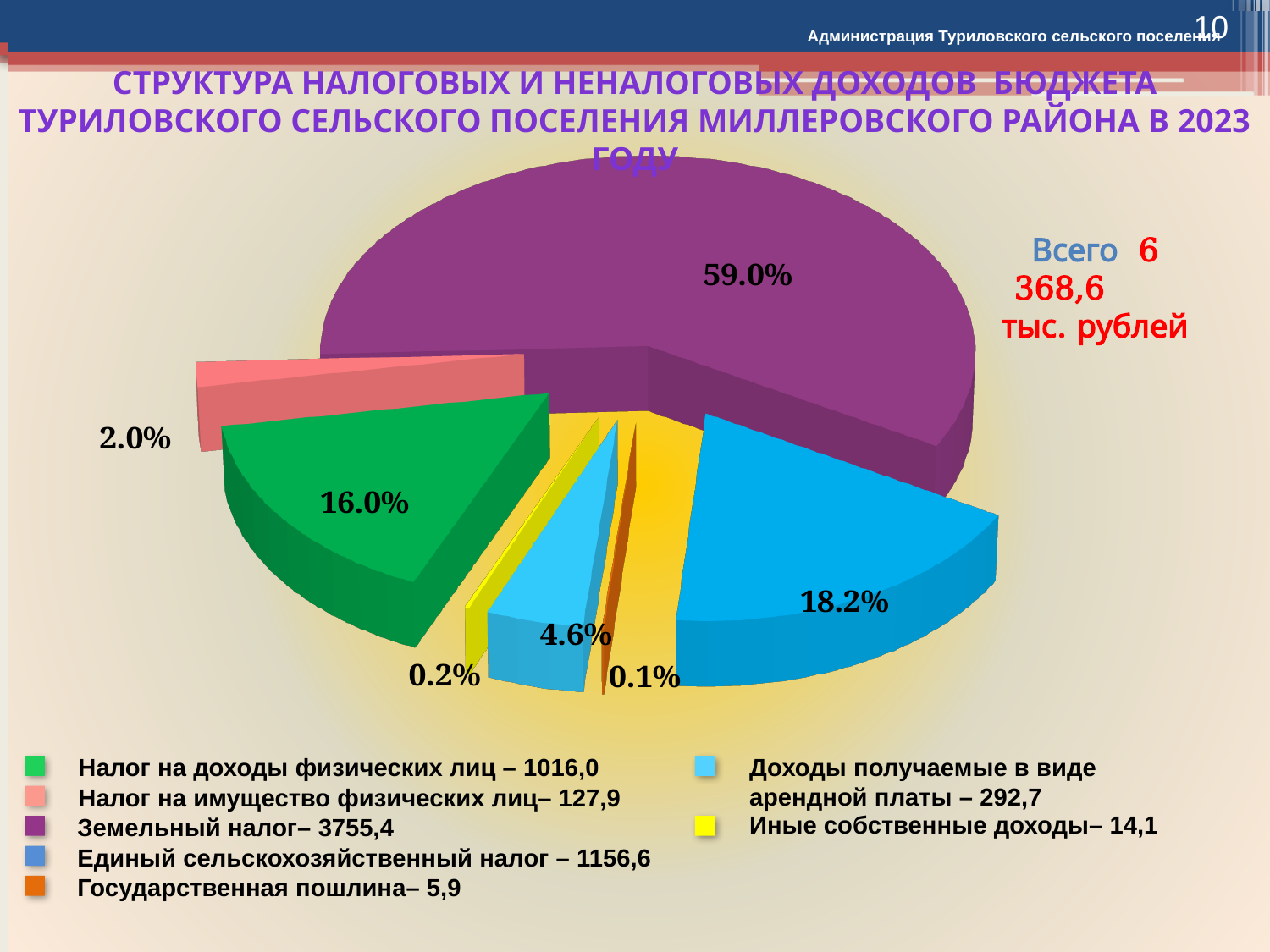
What percentage is shown for the blue slice (Единый сельскохозяйственный налог)? 18.2% How many slices does the pie chart have? 7 What kind of chart is shown on the slide? pie chart Which is larger: the share for Единый сельскохозяйственный налог or the share for Налог на доходы физических лиц? Единый сельскохозяйственный налог Which category has the smallest share of the pie? Государственная пошлина What percentage is shown for the pink slice (Налог на имущество физических лиц)? 2.0% Which category has the largest share of the pie? Земельный налог What value is listed in the legend for Иные собственные доходы? 14,1 What is the difference in percentage points between the 59.0% slice and the 18.2% slice? 40.8 What total amount is stated next to the pie chart? 6 368,6 тыс. рублей What share of the pie does the largest slice (Земельный налог) represent? 59.0% What percentage is shown for the green slice (Налог на доходы физических лиц)? 16.0%